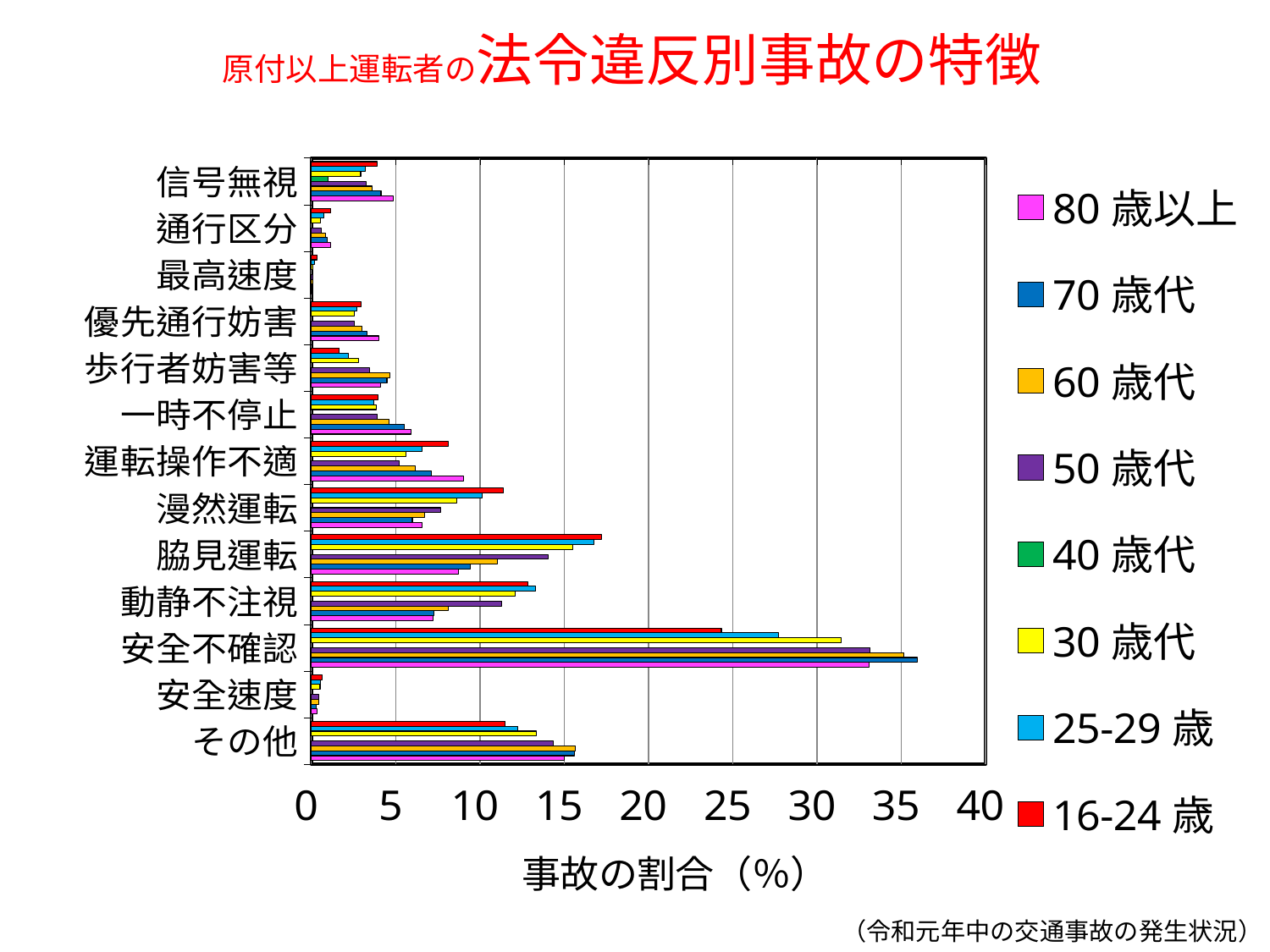
Is the value for 安全不確認 in the 25-29 歳 series greater or less than 25? greater Which violation category has the longest bars in the chart? 安全不確認 Is the value for 安全不確認 in the 80 歳以上 series greater or less than 30? greater What kind of chart is shown on the slide? bar chart What is the title of the horizontal axis of the chart? 事故の割合（%） How many age-group series does the legend list? 8 For 脇見運転, which series has the larger value: 16-24 歳 or 80 歳以上? 16-24 歳 Is the value for 脇見運転 in the 16-24 歳 series greater or less than 15? greater For the 16-24 歳 series, which is larger: 安全不確認 or 脇見運転? 安全不確認 How many violation categories are listed on the vertical axis of the chart? 13 For 安全不確認, which series has the larger value: 16-24 歳 or 80 歳以上? 80 歳以上